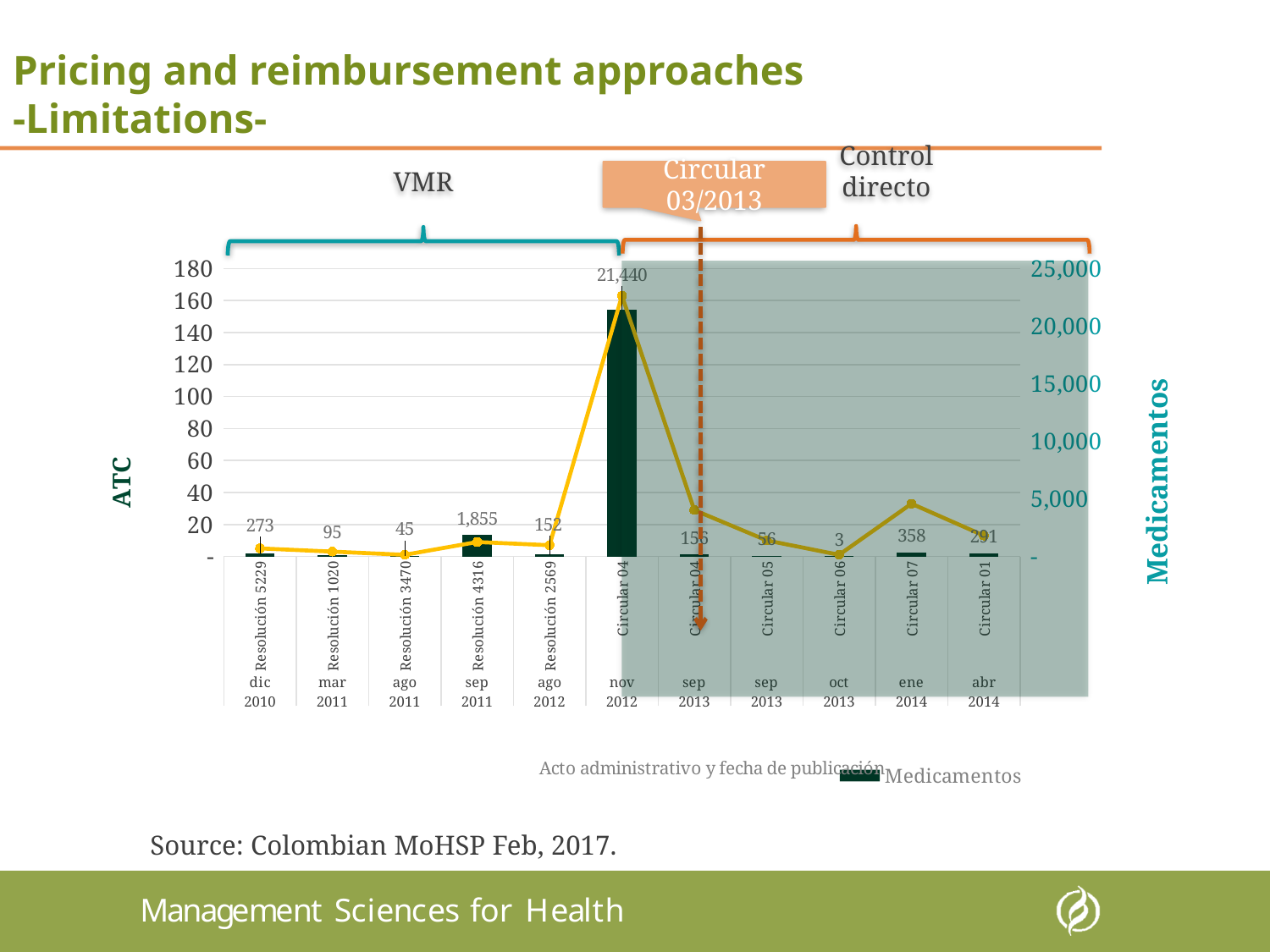
What is the difference between the Medicamentos values for Resolución 5229 and Resolución 1020? 178 Is the ATC value for Resolución 3470 (ago 2011) greater or less than 20? less Which category has the highest Medicamentos value? Circular 04 (nov 2012) Which category has the lowest Medicamentos value? Circular 06 (oct 2013) Which has a larger Medicamentos value, Resolución 5229 or Resolución 1020? Resolución 5229 What is the Medicamentos value for Circular 05 (sep 2013)? 56 How many categories are shown on the x axis of the chart? 11 What is the difference between the Medicamentos values for Circular 07 (ene 2014) and Circular 01 (abr 2014)? 67 What is the Medicamentos value for Resolución 4316 (sep 2011)? 1,855 Is the ATC value for Circular 04 (nov 2012) greater or less than 140? greater What is the Medicamentos value for Circular 04 (nov 2012)? 21,440 What is the title of the left vertical axis of the chart? ATC